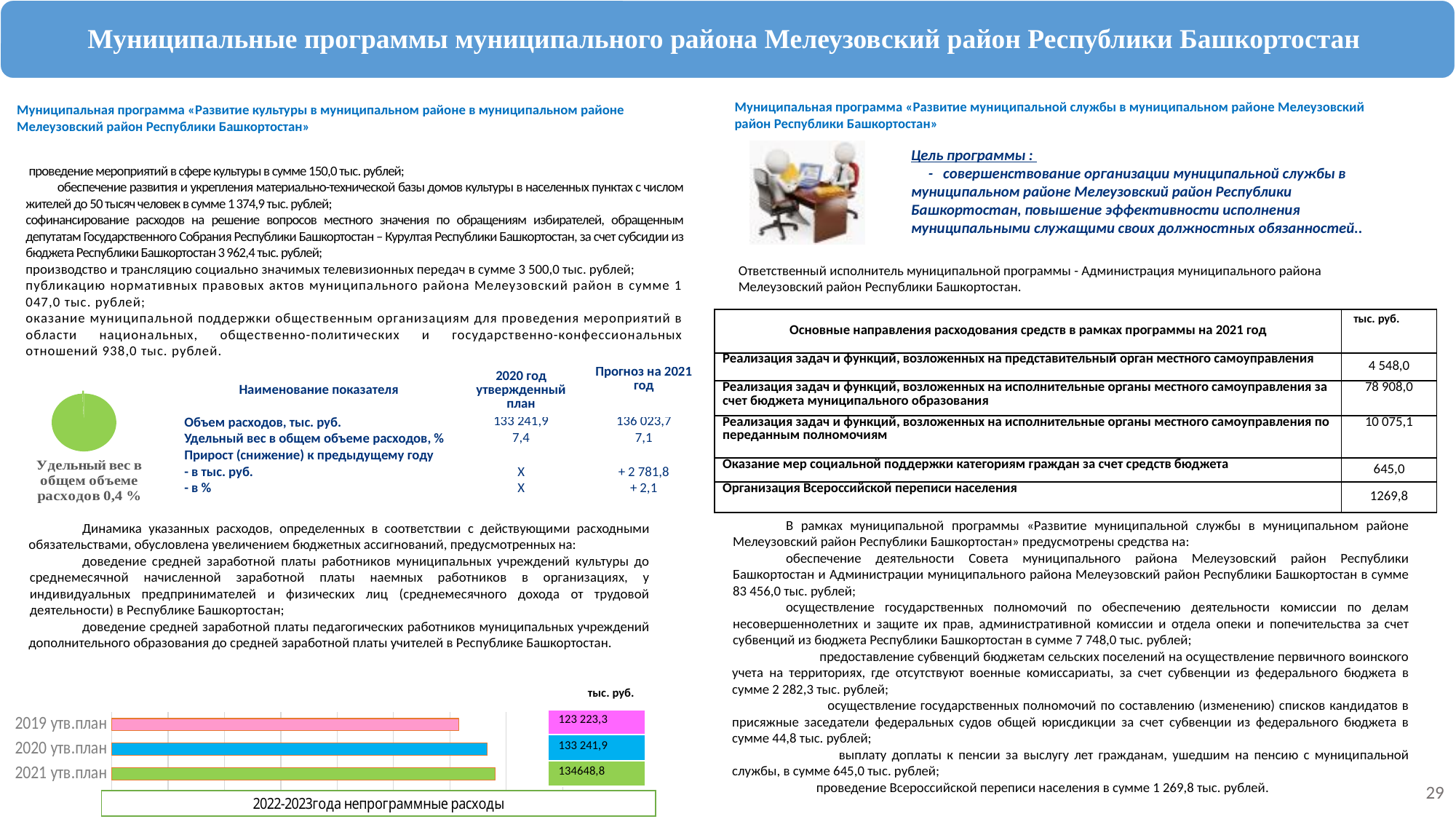
In the bar chart at the bottom left, what is the value for 2019 утв.план? 123 223,3 How many categories are shown in the bar chart at the bottom left? 3 In the bar chart at the bottom left, which is larger: the value for 2019 утв.план or 2020 утв.план? 2020 утв.план What kind of chart is shown at the bottom left of the slide? bar chart In the bar chart at the bottom left, what is the value for 2021 утв.план? 134648,8 In the bar chart at the bottom left, what is the value for 2020 утв.план? 133 241,9 In the bar chart at the bottom left, do the values rise or fall from 2019 утв.план to 2021 утв.план? rise What unit is indicated above the bar chart at the bottom left? тыс. руб. In the bar chart at the bottom left, which category has the lowest value? 2019 утв.план In the bar chart at the bottom left, which category has the highest value? 2021 утв.план In the bar chart at the bottom left, what is the difference between the values for 2020 утв.план and 2019 утв.план? 10 018,6 In the bar chart at the bottom left, what is the difference between the values for 2021 утв.план and 2020 утв.план? 1 406,9